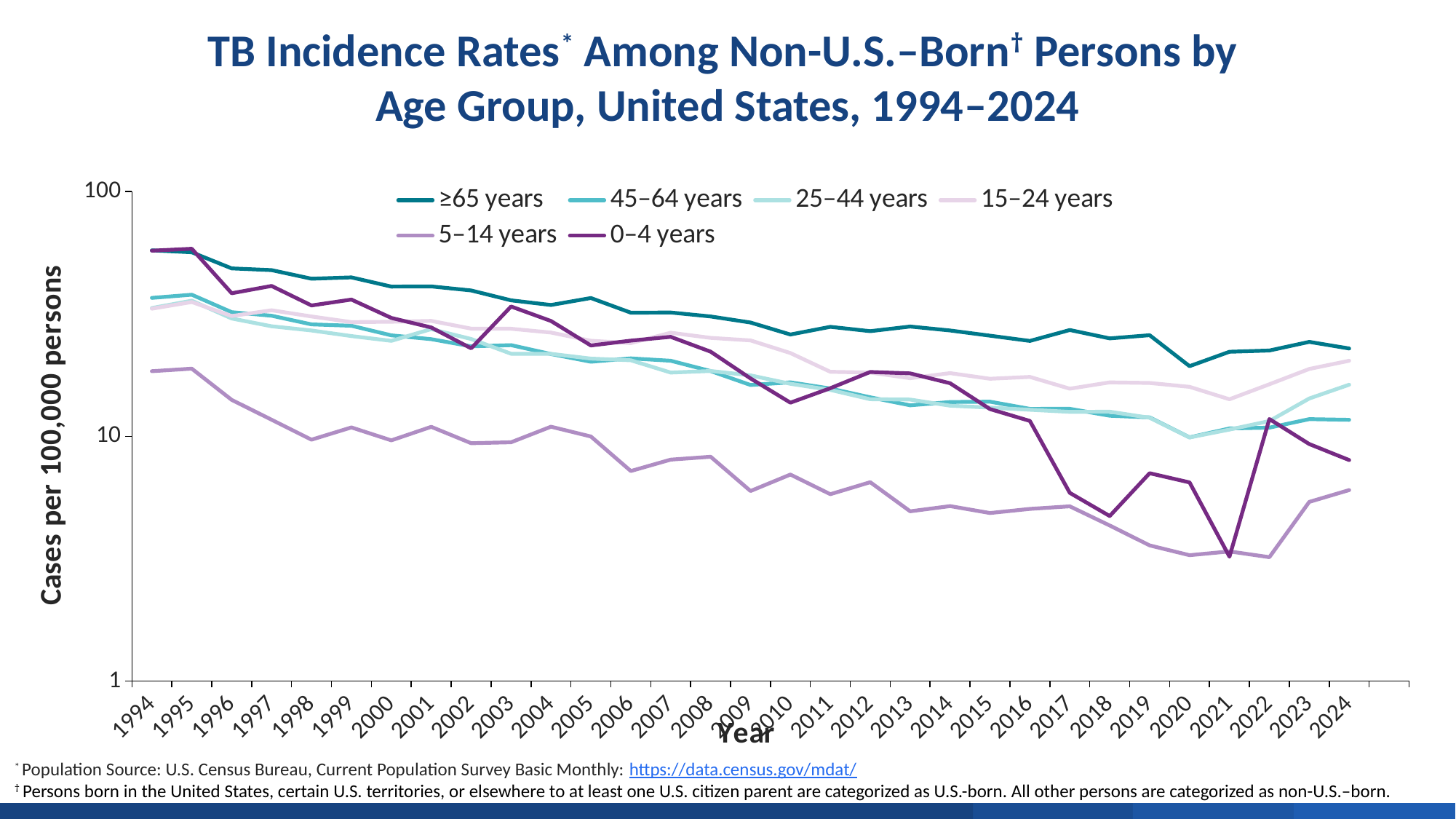
Is the value for 0–4 years in 2021 greater or less than 10? less Does the TB incidence rate for ≥65 years rise or fall from 1994 to 2024? Fall What kind of chart is shown on the slide? Line chart How many series does the legend list? 6 What is the label of the x axis? Year How many years are plotted along the x axis? 31 What is the label of the y axis? Cases per 100,000 persons Which age group has the highest TB incidence rate in 2024? ≥65 years Which age group has the lowest TB incidence rate in 2010? 5–14 years Is the value for 5–14 years in 2021 greater or less than 10? less Is the value for ≥65 years in 1994 greater or less than 10? greater Which is larger in 2024, the value for ≥65 years or the value for 5–14 years? ≥65 years